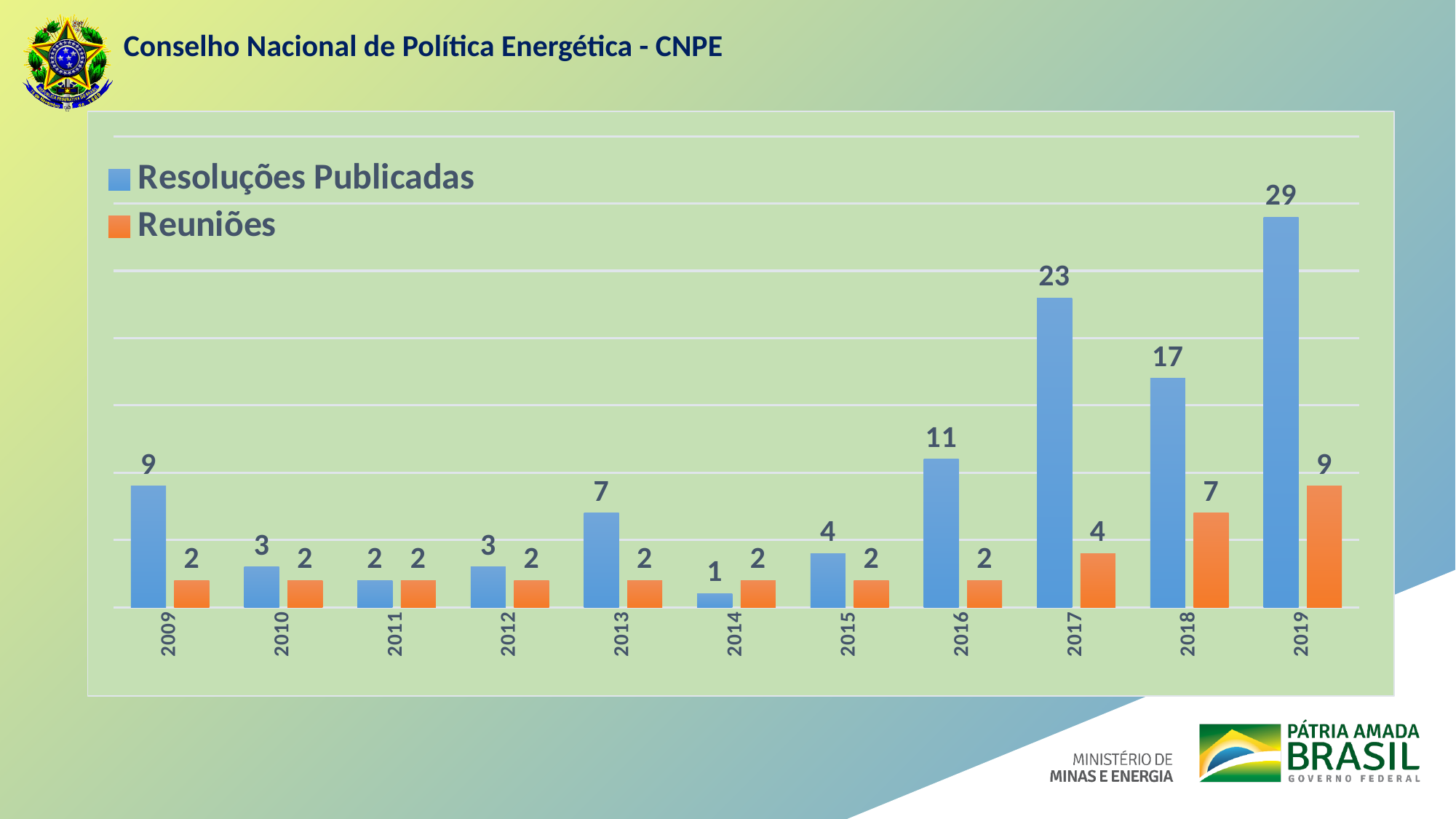
Which year has the lowest value for Resoluções Publicadas? 2014 How many series does the legend list? 2 Do the Reuniões values rise or fall from 2017 to 2019? Rise Which year has the highest value for Resoluções Publicadas? 2019 Which colour represents Reuniões in the legend? Orange What is the value of Resoluções Publicadas for 2014? 1 What kind of chart is shown on the slide? Bar chart Which is larger: Resoluções Publicadas in 2016 or Reuniões in 2019? Resoluções Publicadas in 2016 What is the difference between Resoluções Publicadas in 2017 and 2018? 6 How many years are shown on the x axis? 11 What is the value of Reuniões for 2018? 7 What is the value of Resoluções Publicadas for 2019? 29